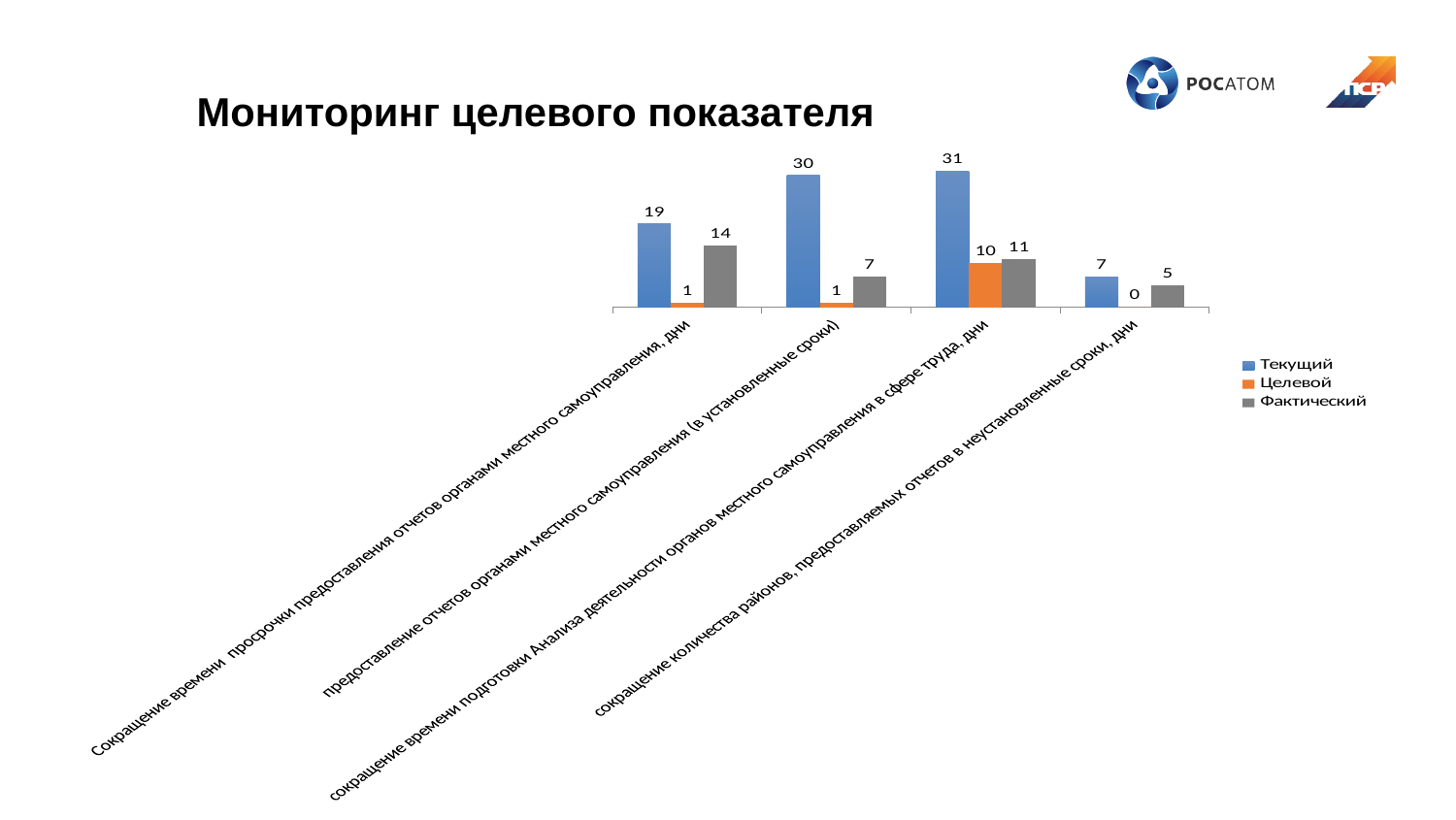
Which category has the lowest Фактический value? сокращение количества районов, предоставляемых отчетов в неустановленные сроки, дни What is the Целевой value for the category "сокращение количества районов, предоставляемых отчетов в неустановленные сроки, дни"? 0 How many categories are shown on the x axis of the chart? 4 What is the Целевой value for the category "сокращение времени подготовки Анализа деятельности органов местного самоуправления в сфере труда, дни"? 10 What is the Текущий value for the category "предоставление отчетов органами местного самоуправления (в установленные сроки)"? 30 What type of chart is shown on the slide? Bar chart Which category has the highest Текущий value? сокращение времени подготовки Анализа деятельности органов местного самоуправления в сфере труда, дни What colour represents the Целевой series in the chart? Orange Which is larger for the category "сокращение времени подготовки Анализа деятельности органов местного самоуправления в сфере труда, дни": the Целевой value or the Фактический value? Фактический What is the Фактический value for the category "Сокращение времени просрочки предоставления отчетов органами местного самоуправления, дни"? 14 How many series does the chart legend list? 3 What is the difference between the Текущий and Фактический values for the category "предоставление отчетов органами местного самоуправления (в установленные сроки)"? 23